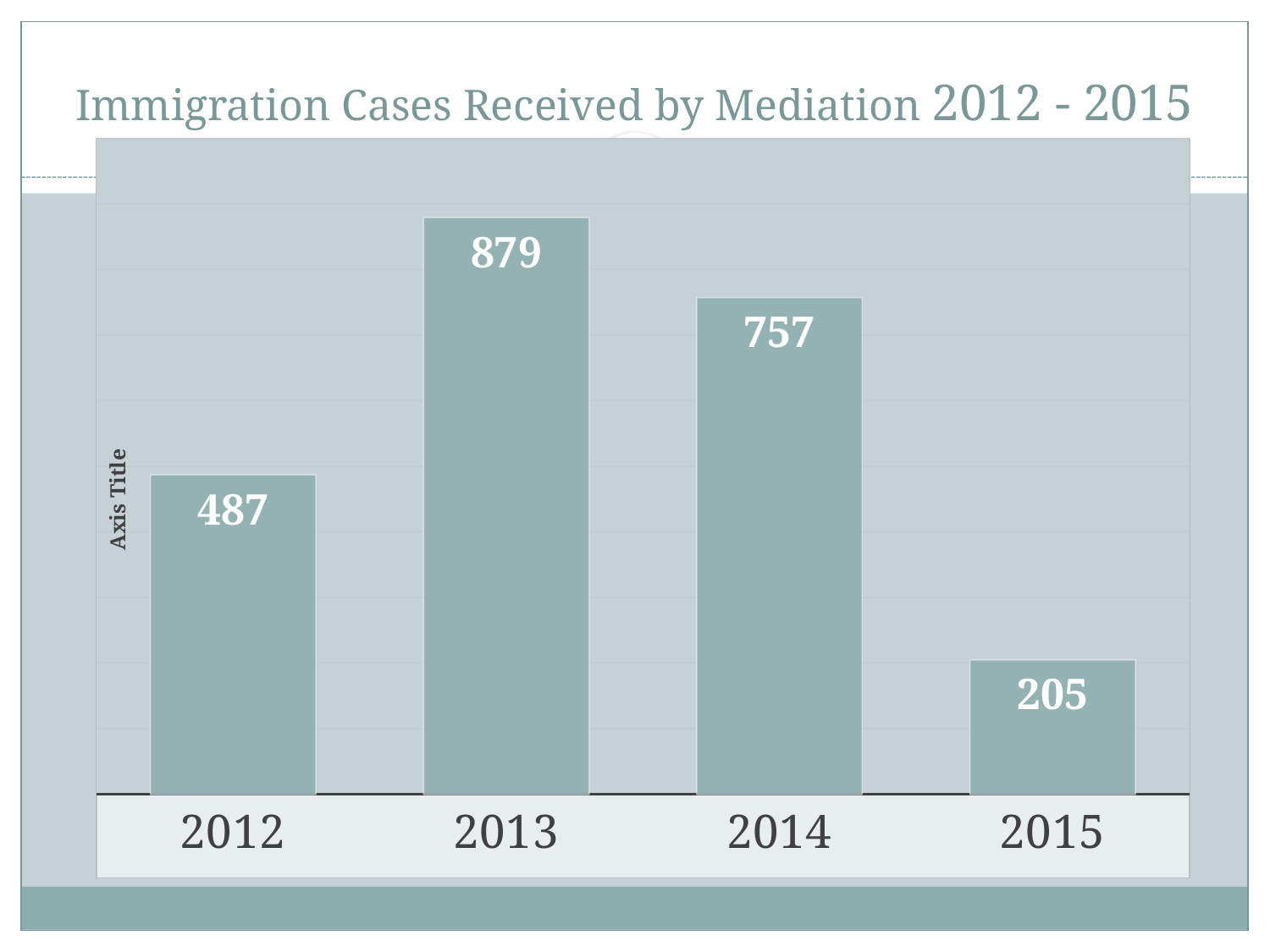
What is the title of the chart? Immigration Cases Received by Mediation 2012 - 2015 What is the difference between the values for 2013 and 2014? 122 Which year has the lowest number of cases? 2015 What kind of chart is shown on the slide? Bar chart What is the difference between the values for 2012 and 2015? 282 How many years are shown on the x axis? 4 Do the values rise or fall from 2013 to 2015? Fall What is the value shown for 2012? 487 Which year has the highest number of cases? 2013 How many immigration cases were received by mediation in 2013? 879 Which year has the larger value, 2012 or 2014? 2014 What is the value shown for 2015? 205